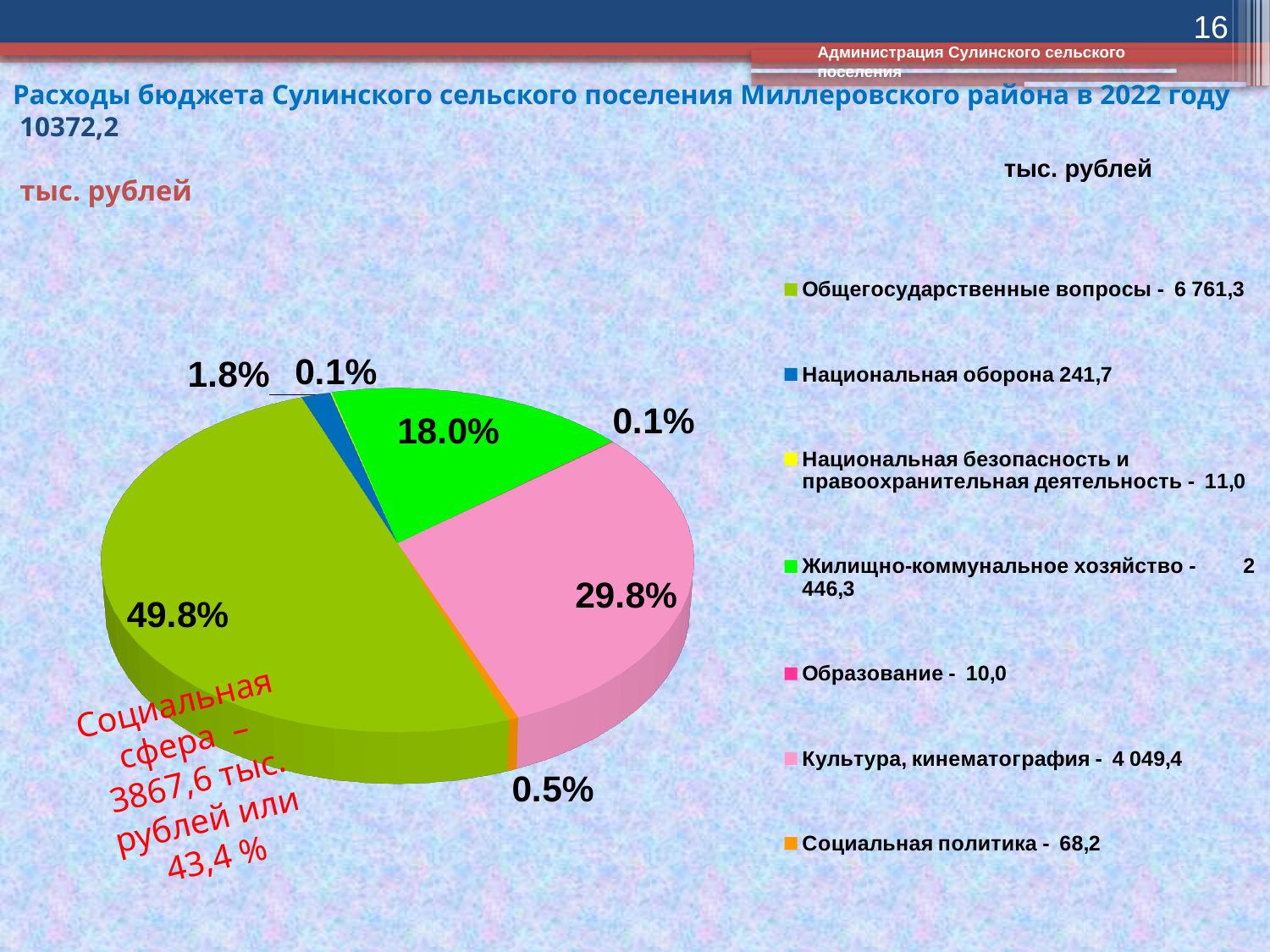
What share of the pie does Общегосударственные вопросы take? 49.8% How many entries does the legend list? 7 How many slices does the pie chart have? 7 What value does the legend give for Социальная политика? 68,2 What is the difference in percentage points between the Общегосударственные вопросы slice and the Культура, кинематография slice? 20.0% What share of the pie does Национальная оборона take? 1.8% Which category has the largest slice of the pie? Общегосударственные вопросы What share of the pie does Жилищно-коммунальное хозяйство take? 18.0% Which is larger, the share for Культура, кинематография or the share for Жилищно-коммунальное хозяйство? Культура, кинематография What kind of chart is shown on the slide? pie chart What value does the legend give for Жилищно-коммунальное хозяйство? 2 446,3